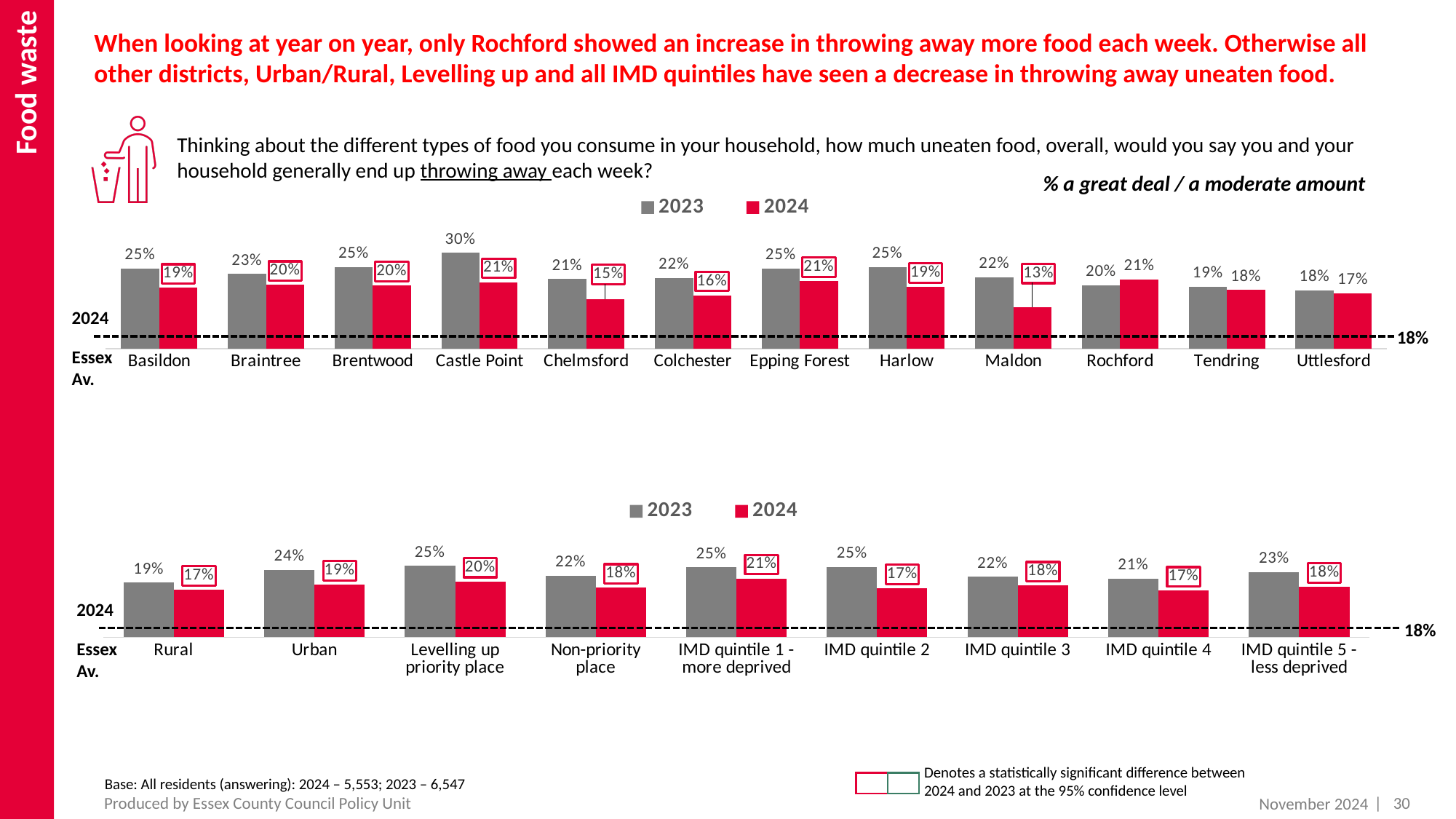
How many series does the legend of the bottom chart list? 2 In the top chart (districts), what is the difference between the 2023 and 2024 values for Chelmsford? 6 percentage points In the top chart (districts), which is larger for Rochford: the 2023 value or the 2024 value? 2024 What type of chart is the bottom chart? Bar chart In the top chart (districts), which district has the highest 2023 value? Castle Point In the top chart (districts), what is the 2023 value for Castle Point? 30% In the top chart (districts), what is the 2024 value for Maldon? 13% In the top chart (districts), which district has the lowest 2024 value? Maldon How many districts are shown in the top chart? 12 In the bottom chart, what is the 2023 value for Urban? 24% In the bottom chart, what is the 2024 value for IMD quintile 1 - more deprived? 21% In the bottom chart, what is the difference between the 2023 and 2024 values for IMD quintile 2? 8 percentage points